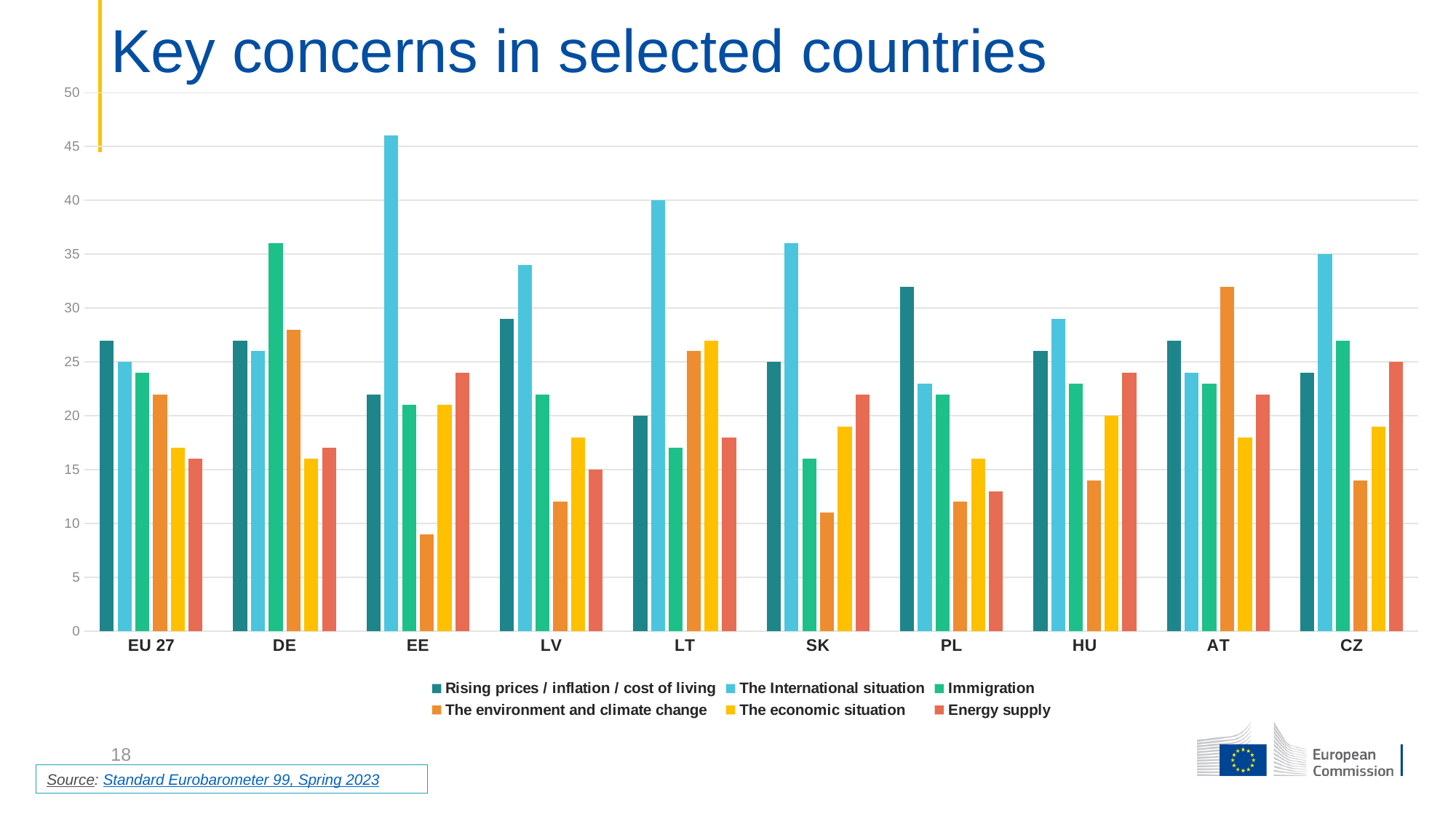
Is the value for Rising prices / inflation / cost of living in PL greater or less than 30? greater What is the title of the chart? Key concerns in selected countries Which country has the highest bar for The International situation? EE In AT, which is larger: The environment and climate change or Rising prices / inflation / cost of living? The environment and climate change Which country has the lowest bar for The environment and climate change? EE How many series does the legend list? 6 Is the value for The environment and climate change in EE greater or less than 10? less In DE, which is larger: Immigration or Rising prices / inflation / cost of living? Immigration What is the value for The International situation in LT? 40 What kind of chart is shown on the slide? Bar chart How many countries/categories are shown on the x axis? 10 Is the value for The International situation in EE greater or less than 45? greater